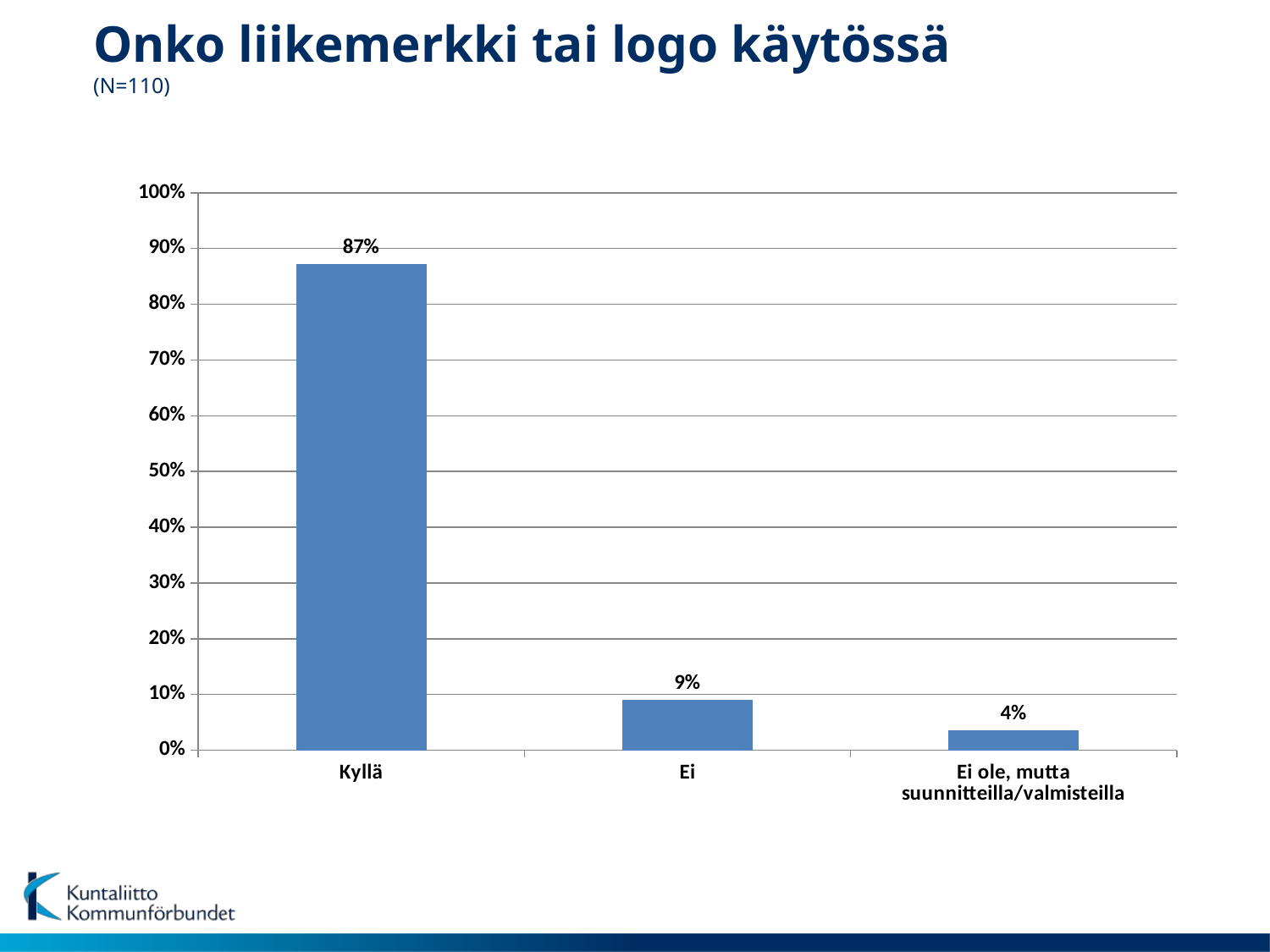
Which is larger, the value for Ei or the value for Ei ole, mutta suunnitteilla/valmisteilla? Ei What is the value for Ei? 9% Which category has the lowest value? Ei ole, mutta suunnitteilla/valmisteilla How many categories are shown on the x axis? 3 What is the value for Kyllä? 87% What kind of chart is shown on the slide? bar chart What is the value for Ei ole, mutta suunnitteilla/valmisteilla? 4% Is the value for Kyllä greater or less than 80%? greater What is the title of the chart on the slide? Onko liikemerkki tai logo käytössä What is the difference between the values for Ei and Ei ole, mutta suunnitteilla/valmisteilla? 5% Which category has the highest value? Kyllä What is the difference between the values for Kyllä and Ei? 78%